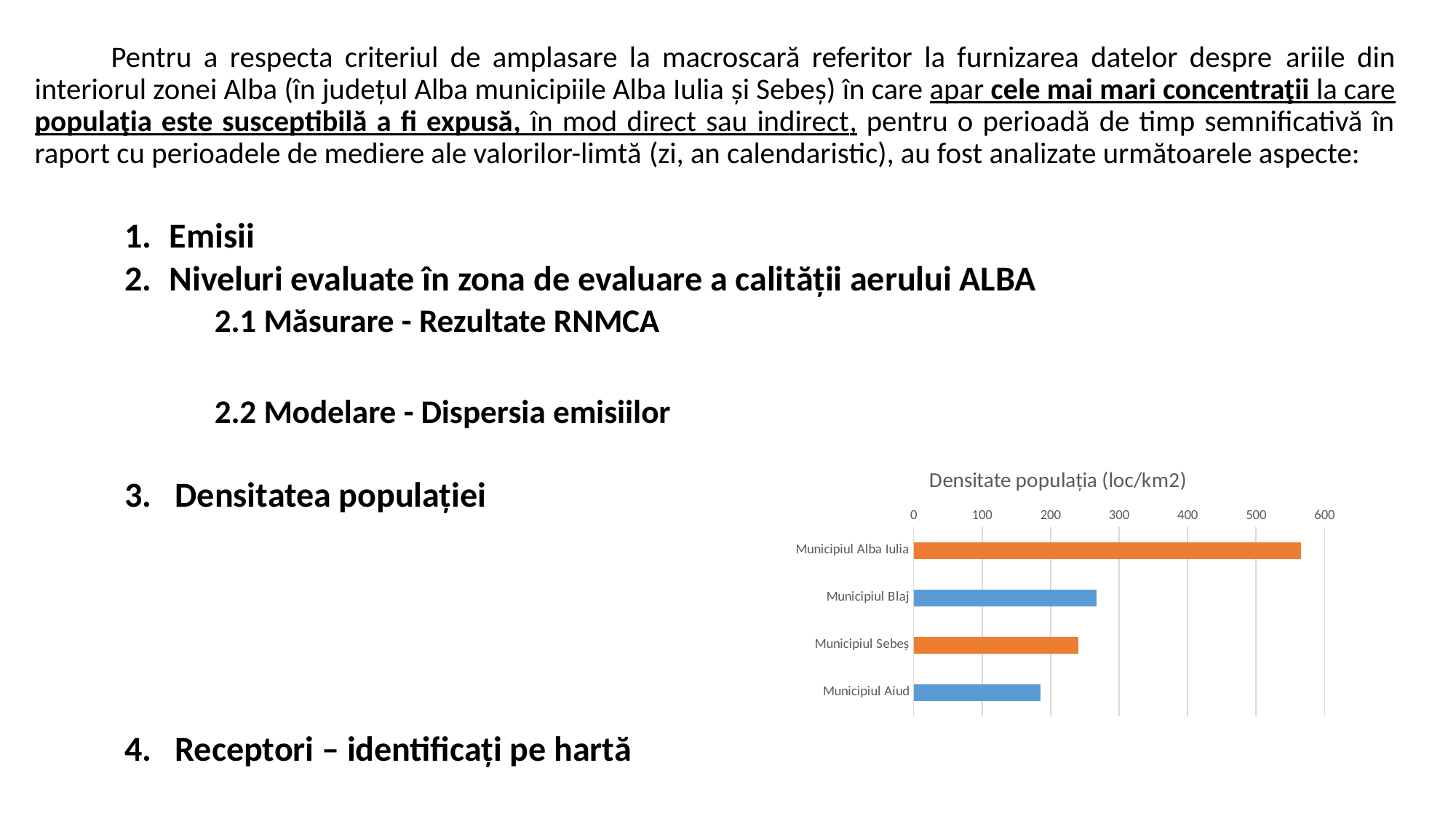
What colour is the bar for Municipiul Sebeș? orange How many municipalities are shown in the chart? 4 Is the value for Municipiul Aiud greater or less than 100? greater Is the value for Municipiul Alba Iulia greater or less than 500? greater What kind of chart is shown on the slide? bar chart Which municipality has the lowest population density in the chart? Municipiul Aiud What is the title of the chart on the slide? Densitate populația (loc/km2) Is the value for Municipiul Alba Iulia greater or less than 600? less Which municipality has the highest population density in the chart? Municipiul Alba Iulia Which has a higher population density, Municipiul Sebeș or Municipiul Aiud? Municipiul Sebeș